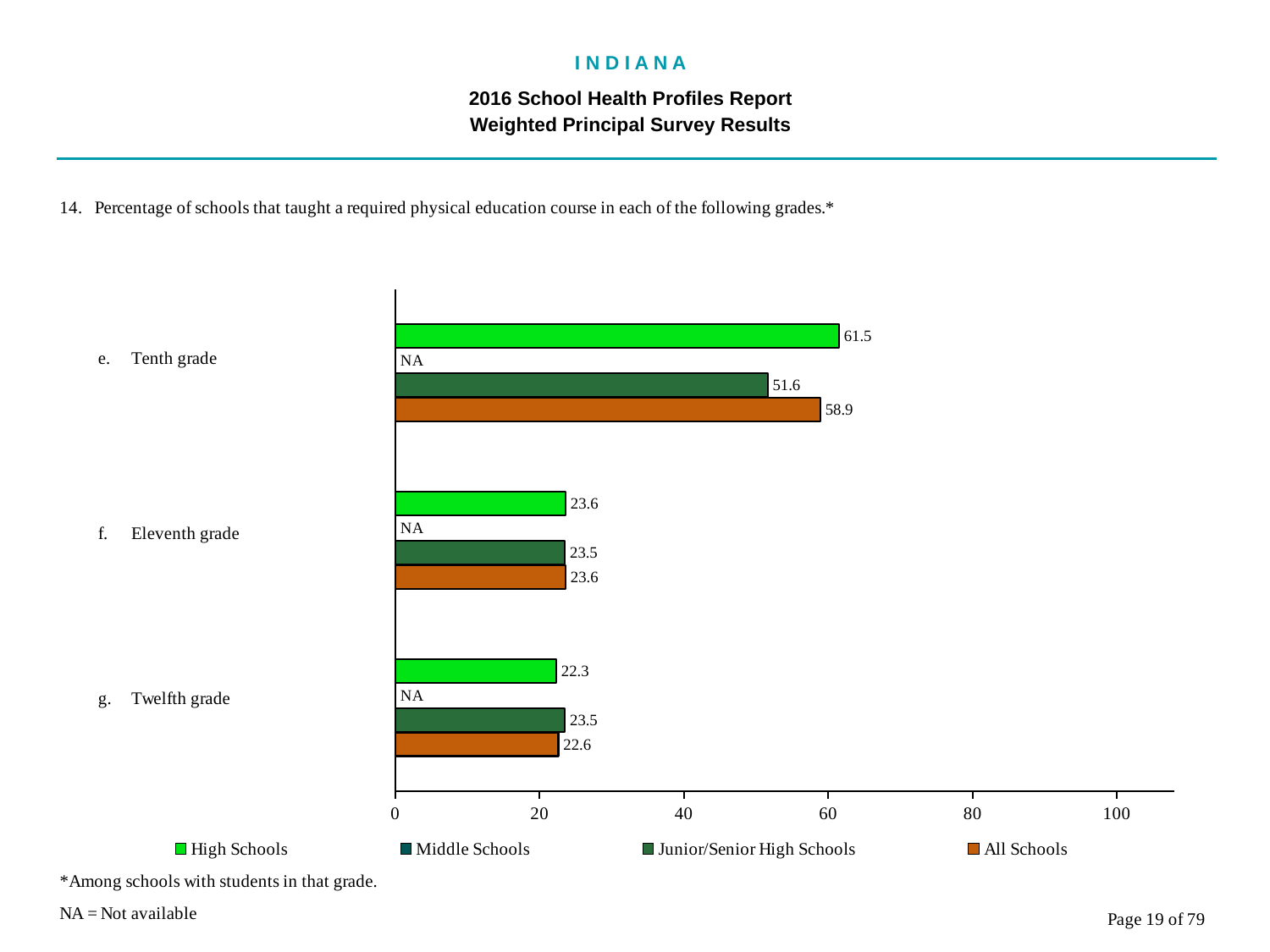
How many series does the legend list? 4 What kind of chart is shown on the slide? bar chart What is the value for Junior/Senior High Schools in Eleventh grade? 23.5 Which grade has the lowest value for High Schools? Twelfth grade Which grade has the highest value for All Schools? Tenth grade What is the value for High Schools in Tenth grade? 61.5 How many grade categories are shown on the chart? 3 What is the value for All Schools in Twelfth grade? 22.6 Which is larger in Tenth grade: the All Schools value or the Junior/Senior High Schools value? All Schools What is the difference between the High Schools value and the Junior/Senior High Schools value in Tenth grade? 9.9 Is the value for High Schools in Tenth grade greater or less than 60? greater What value is shown for Middle Schools in Tenth grade? NA